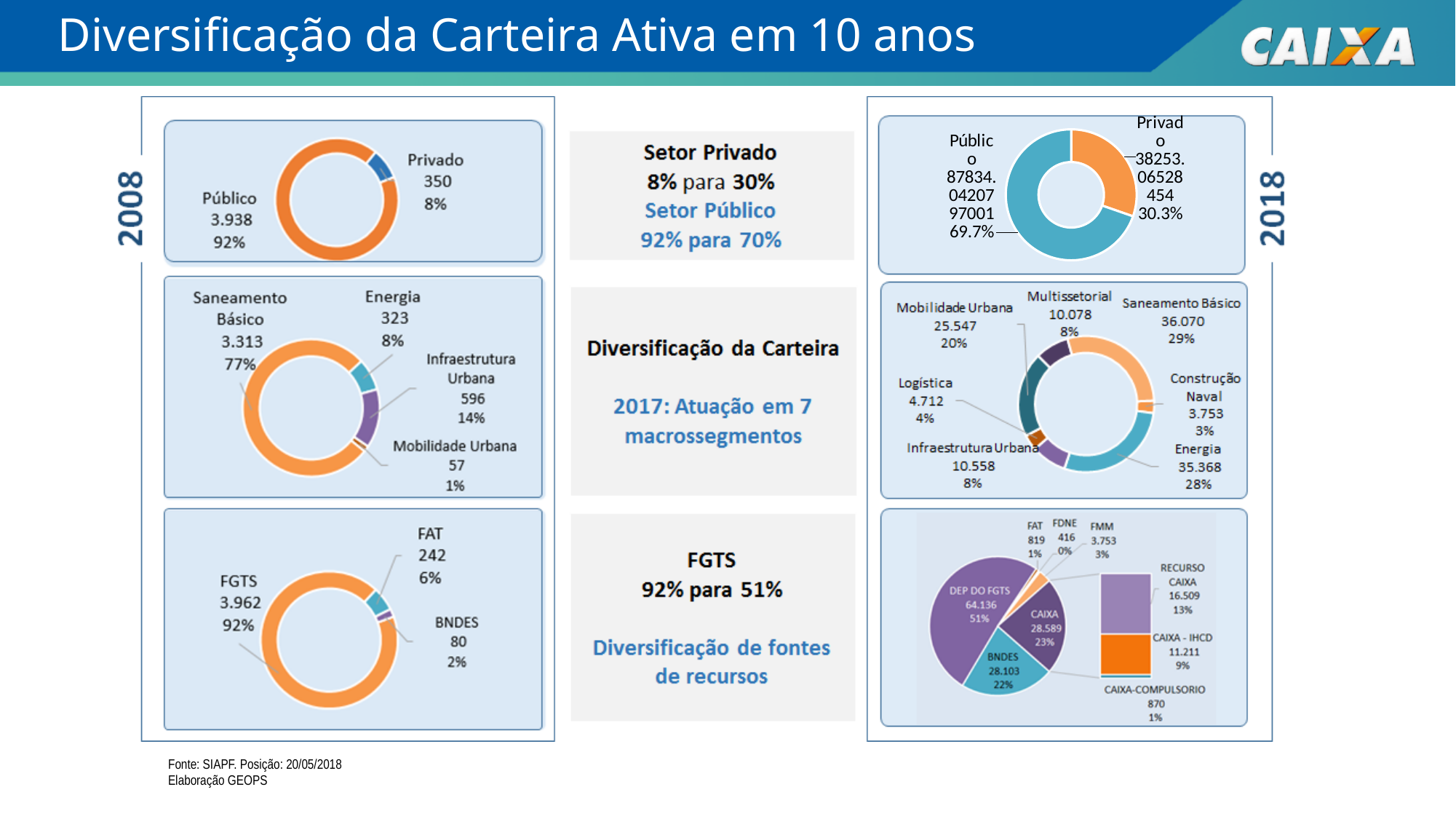
In the 2008 bottom donut chart (funding sources), what value is shown for BNDES? 80 In the 2008 top donut chart (Público vs Privado), what value is shown for Privado? 350 In the 2018 middle donut chart (sectors), which is larger: Saneamento Básico or Mobilidade Urbana? Saneamento Básico How many sectors are shown in the 2018 middle donut chart? 7 In the 2008 middle donut chart (sectors), what value is shown for Infraestrutura Urbana? 596 In the 2008 middle donut chart (sectors), which sector has the smallest value? Mobilidade Urbana In the 2018 bottom chart (funding sources), what value is shown for CAIXA - IHCD? 11.211 In the 2018 middle donut chart (sectors), what value is shown for Energia? 35.368 In the 2008 top donut chart, what share of the portfolio is Público? 92% In the 2018 bottom chart (funding sources), what share is shown for DEP DO FGTS? 51% In the 2018 top donut chart (Público vs Privado), what percentage is shown for Privado? 30.3% In the 2008 middle donut chart (sectors), which sector has the largest value? Saneamento Básico